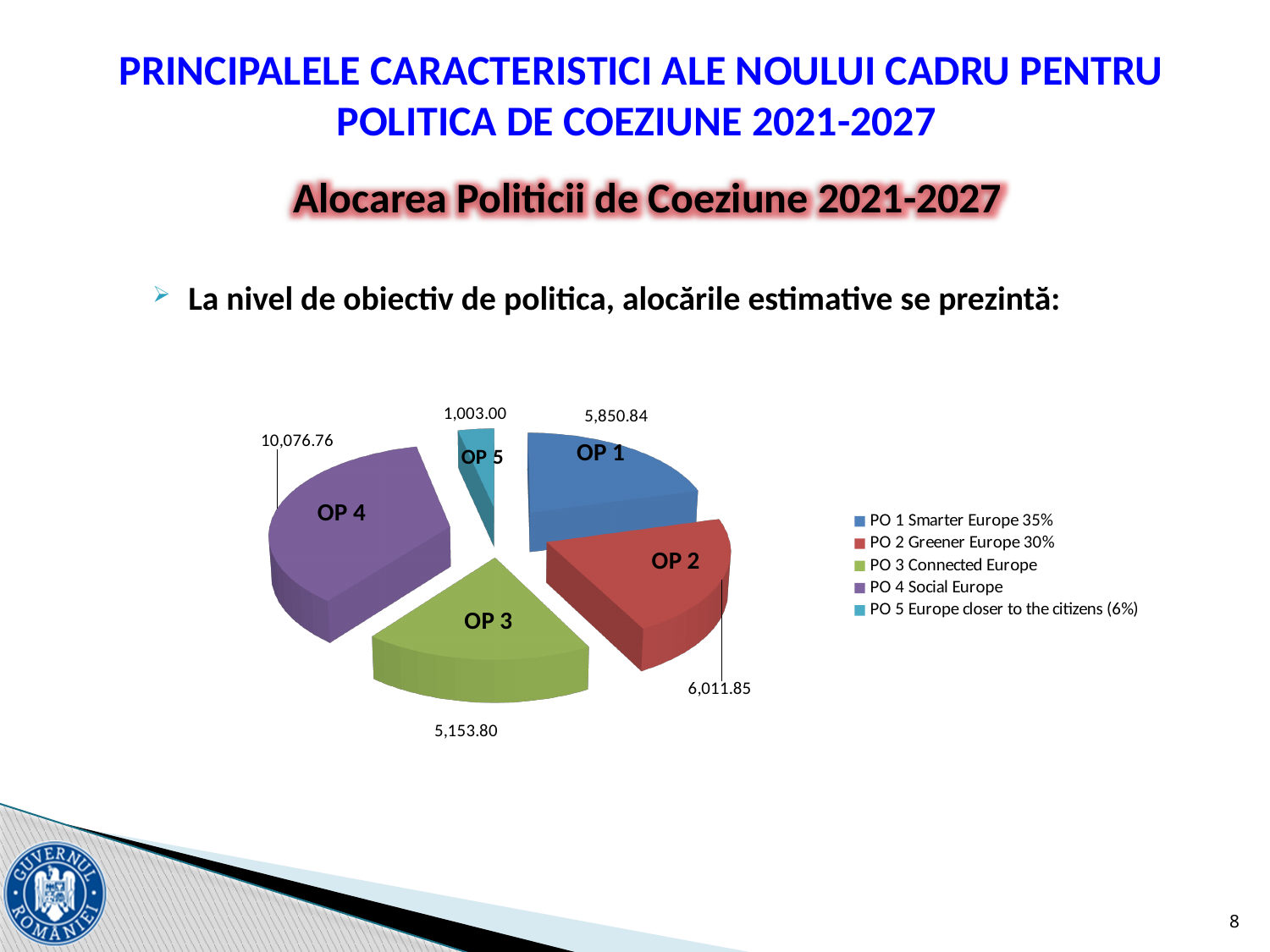
What is the difference between the values for OP 4 and OP 1? 4,225.92 What type of chart is shown on the slide? pie chart Which slice has the smallest value? OP 5 How many slices does the pie chart have? 5 What is the value shown for the OP 3 slice? 5,153.80 What is the difference between the values for OP 2 and OP 3? 858.05 Which has a larger value, OP 2 or OP 1? OP 2 Which slice has the largest value? OP 4 How many entries does the legend list? 5 What is the value shown for the OP 5 slice? 1,003.00 What is the value shown for the OP 1 slice? 5,850.84 What is the value shown for the OP 4 slice? 10,076.76